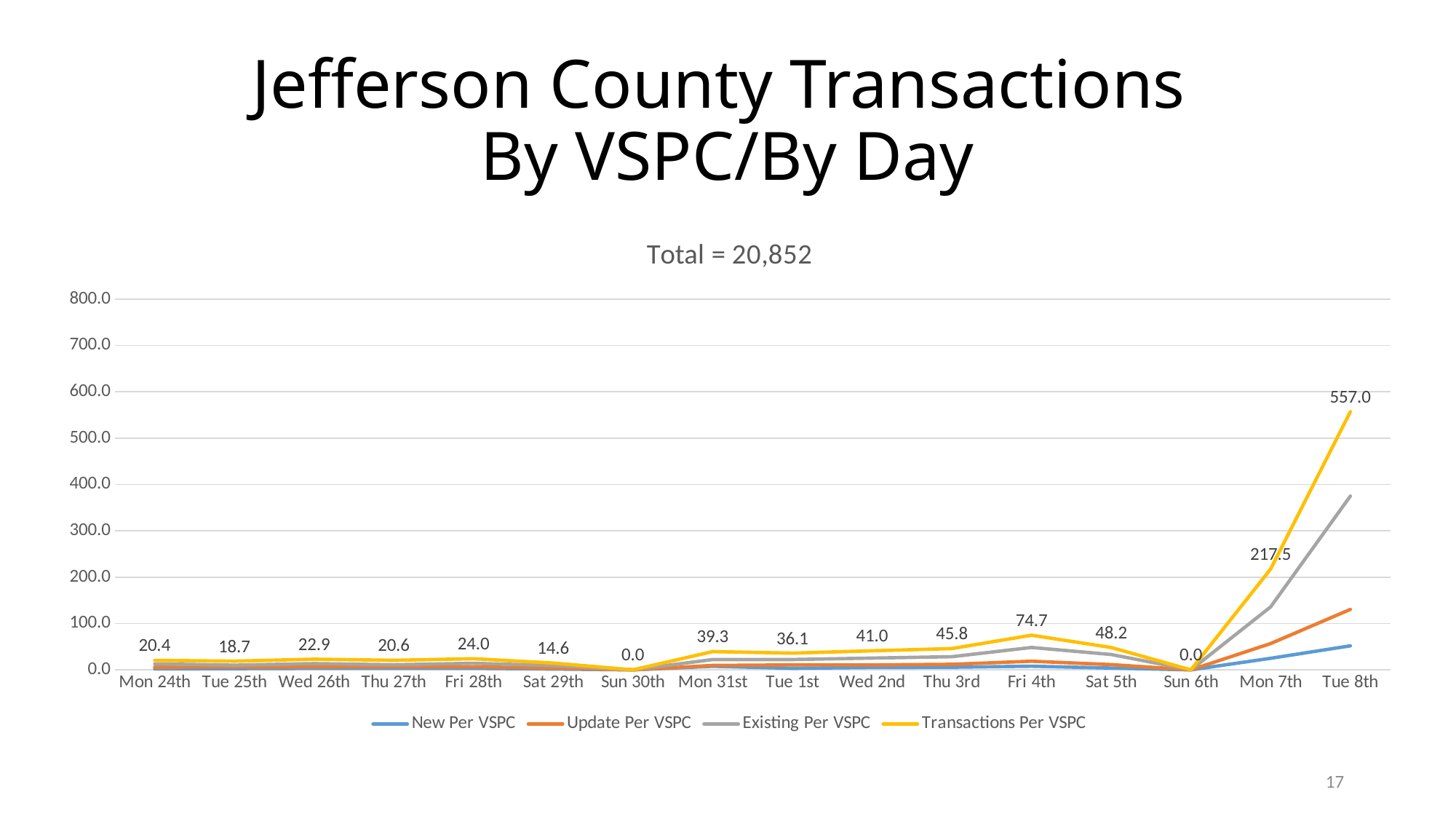
What is the Transactions Per VSPC value on Mon 7th? 217.5 What is the Transactions Per VSPC value on Tue 8th? 557.0 How many days are plotted along the x axis? 16 What is the Transactions Per VSPC value on Fri 4th? 74.7 Is the Existing Per VSPC value on Tue 8th greater or less than 300? greater What total is stated in the chart's subtitle? Total = 20,852 What kind of chart is shown on the slide? line chart Do the Transactions Per VSPC values rise or fall from Sun 6th to Tue 8th? rise Which day has the larger Transactions Per VSPC value, Fri 4th or Sat 5th? Fri 4th How many series does the legend list? 4 What is the difference in Transactions Per VSPC between Tue 8th and Mon 7th? 339.5 On which day is Transactions Per VSPC highest? Tue 8th